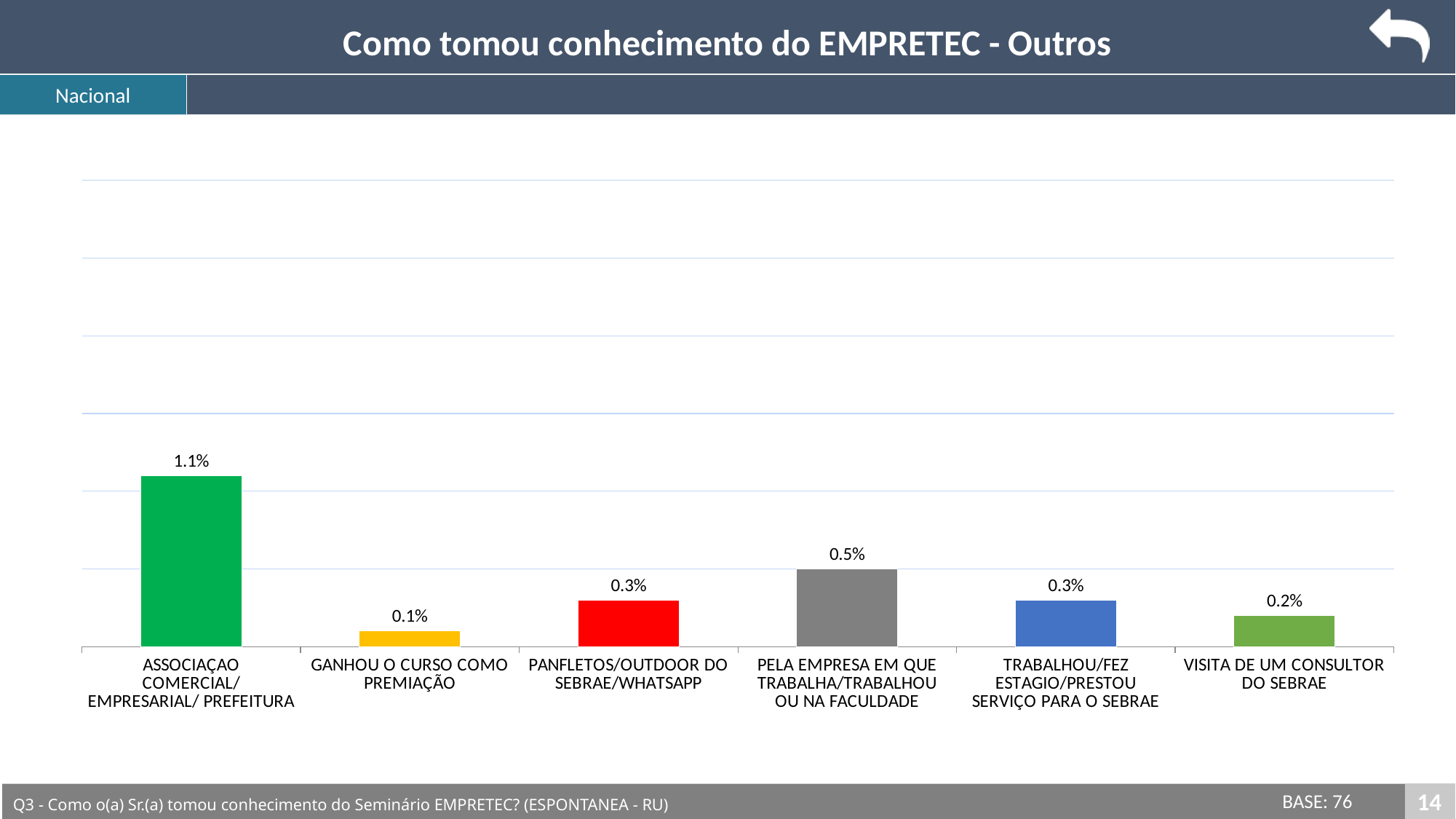
What is the value for ASSOCIAÇÃO COMERCIAL/ EMPRESARIAL/ PREFEITURA? 1.1% What is the title of the slide? Como tomou conhecimento do EMPRETEC - Outros What is the value for VISITA DE UM CONSULTOR DO SEBRAE? 0.2% What is the difference between the values for ASSOCIAÇÃO COMERCIAL/ EMPRESARIAL/ PREFEITURA and PELA EMPRESA EM QUE TRABALHA/TRABALHOU OU NA FACULDADE? 0.6% Which category has the lowest value? GANHOU O CURSO COMO PREMIAÇÃO What kind of chart is shown on the slide? Bar chart What is the value for GANHOU O CURSO COMO PREMIAÇÃO? 0.1% Which category has the highest value? ASSOCIAÇÃO COMERCIAL/ EMPRESARIAL/ PREFEITURA What is the base (number of respondents) shown on the slide? 76 How many categories are shown in the chart? 6 What is the value for PELA EMPRESA EM QUE TRABALHA/TRABALHOU OU NA FACULDADE? 0.5% Which is larger: the value for PANFLETOS/OUTDOOR DO SEBRAE/WHATSAPP or the value for VISITA DE UM CONSULTOR DO SEBRAE? PANFLETOS/OUTDOOR DO SEBRAE/WHATSAPP